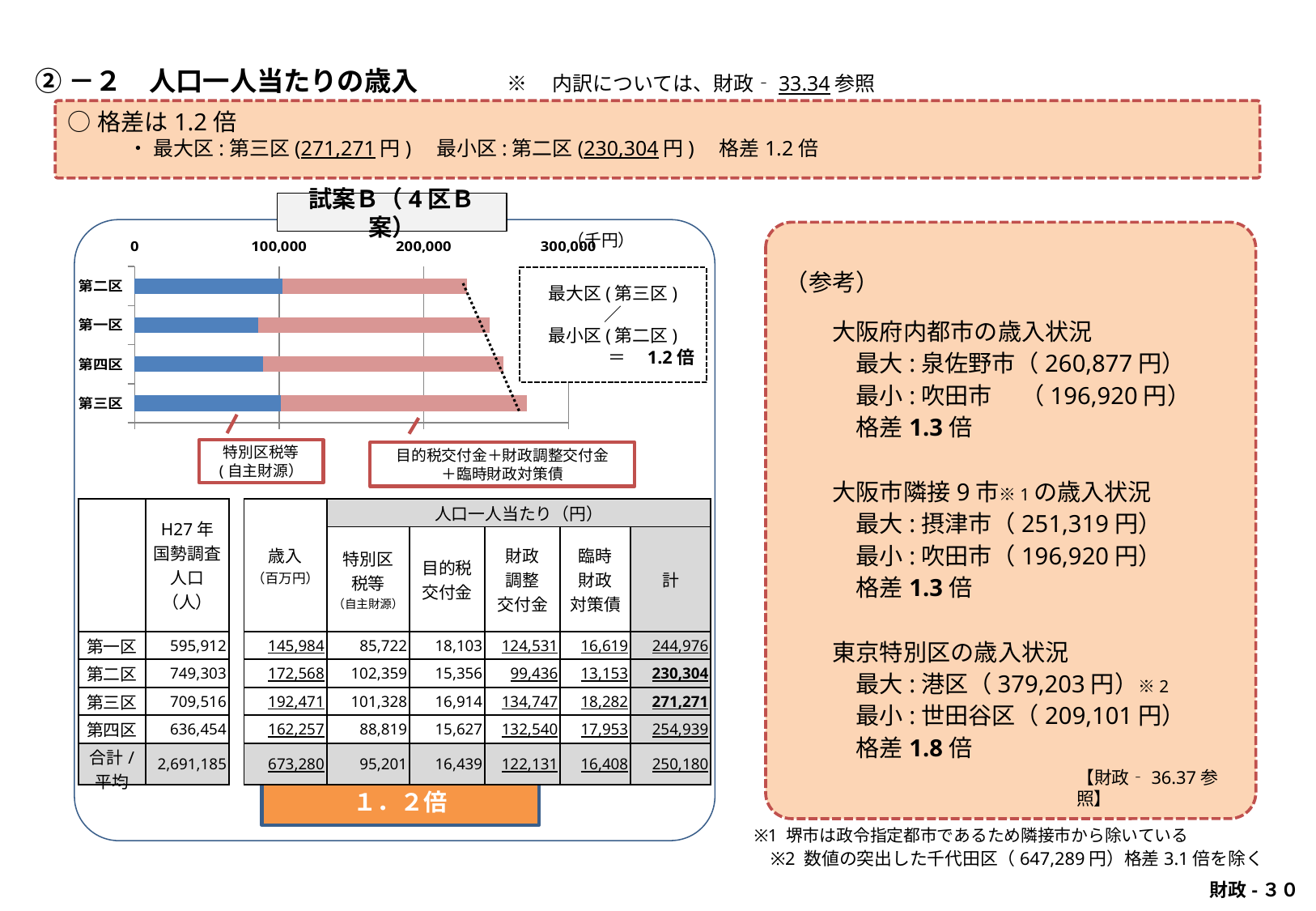
Is the blue segment (特別区税等) for 第一区 greater or less than 100,000? less Which district has the shortest total bar (lowest per-capita revenue) in the chart? 第二区 Which is larger, the total bar for 第三区 or the total bar for 第一区? 第三区 Which district has the longest total bar (highest per-capita revenue) in the chart? 第三区 What is the difference between the per-capita revenue totals of 第三区 (271,271) and 第二区 (230,304)? 40,967 What is the per-capita revenue total (計) for 第二区 shown in the table under the chart? 230,304 How many districts (categories) are plotted in the bar chart? 4 Is the total bar for 第三区 greater or less than 200,000? greater How many series does the bar chart show (as indicated by the two labelled boxes below it)? 2 What kind of chart is shown on the slide? Stacked horizontal bar chart What is the per-capita revenue total (計) for 第三区 shown in the table under the chart? 271,271 What ratio between the largest and smallest district is shown in the dashed box next to the chart? 1.2倍